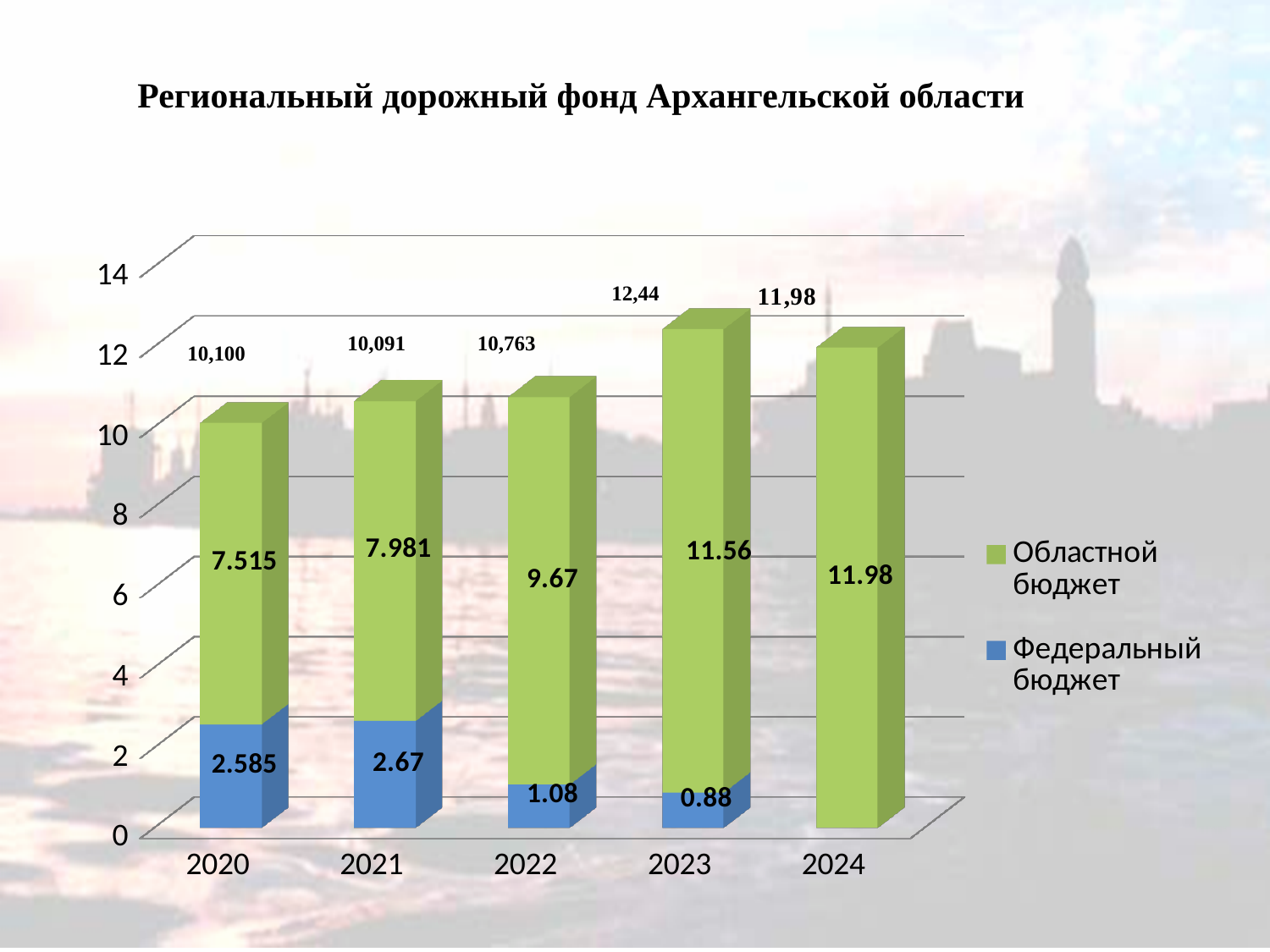
What is the value of Федеральный бюджет for 2023? 0.88 What is the value of Областной бюджет for 2024? 11.98 What kind of chart is shown on the slide? Stacked bar chart What is the value of Федеральный бюджет for 2020? 2.585 How many series does the legend list? 2 What total is printed above the stacked bar for 2023? 12,44 What is the value of Областной бюджет for 2022? 9.67 What total is printed above the stacked bar for 2021? 10,091 Is the value of Федеральный бюджет larger in 2021 or in 2022? 2021 Which year has the highest value for Областной бюджет? 2024 Which year has the lowest labelled value for Федеральный бюджет? 2023 How many years are shown on the x axis? 5